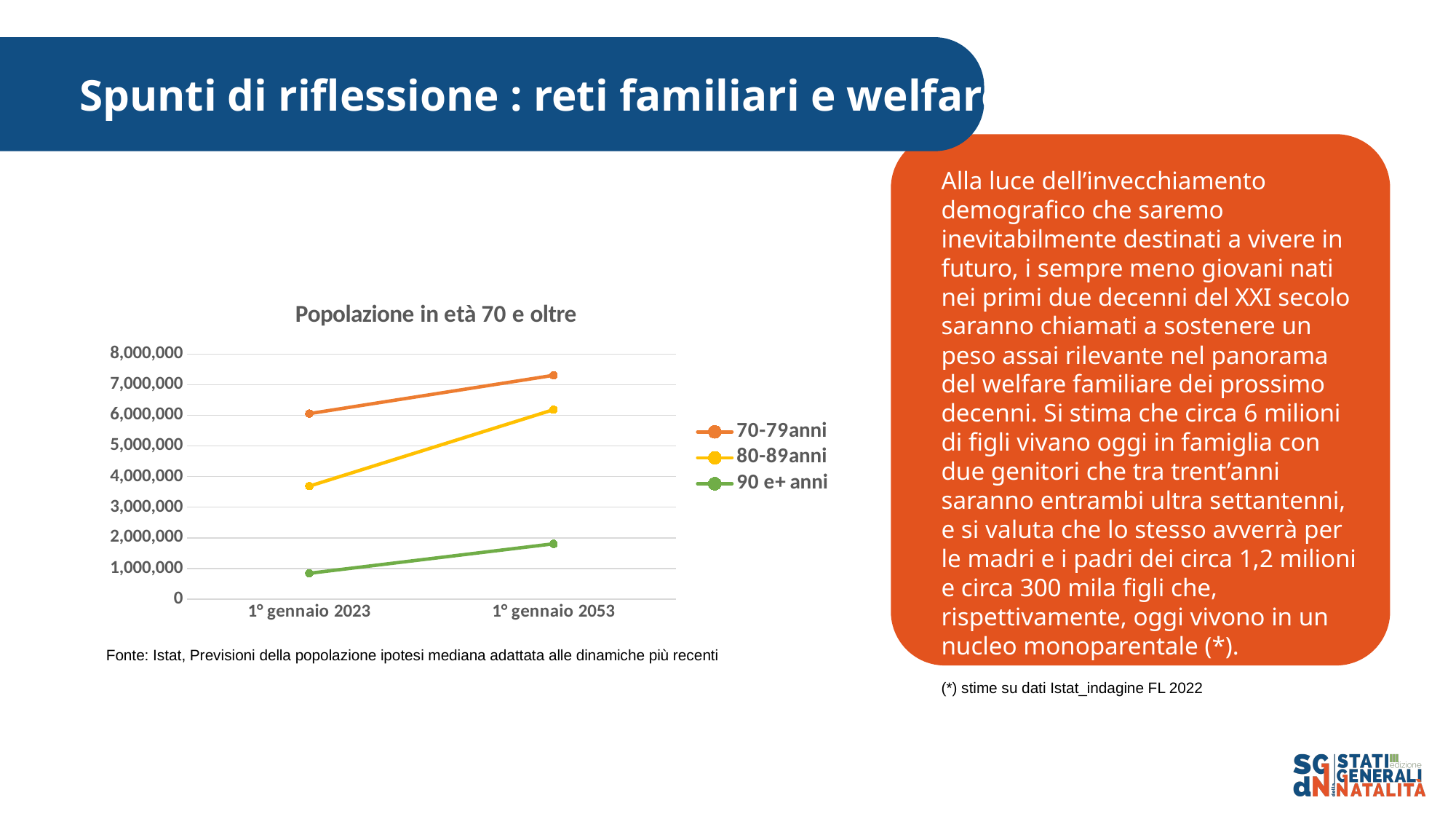
Is the value for 90 e+ anni at 1° gennaio 2023 greater or less than 1,000,000? less Which series has the lowest value at 1° gennaio 2023? 90 e+ anni What kind of chart is shown on the slide? line chart Which series has the highest value at 1° gennaio 2053? 70-79anni Does the value for 80-89anni rise or fall from 1° gennaio 2023 to 1° gennaio 2053? rise At 1° gennaio 2053, which is larger: the value for 80-89anni or the value for 90 e+ anni? 80-89anni Is the value for 90 e+ anni at 1° gennaio 2053 greater or less than 2,000,000? less Is the value for 80-89anni at 1° gennaio 2023 greater or less than 4,000,000? less How many points along the x axis does the chart show? 2 What is the title of the chart? Popolazione in età 70 e oltre How many series does the chart legend list? 3